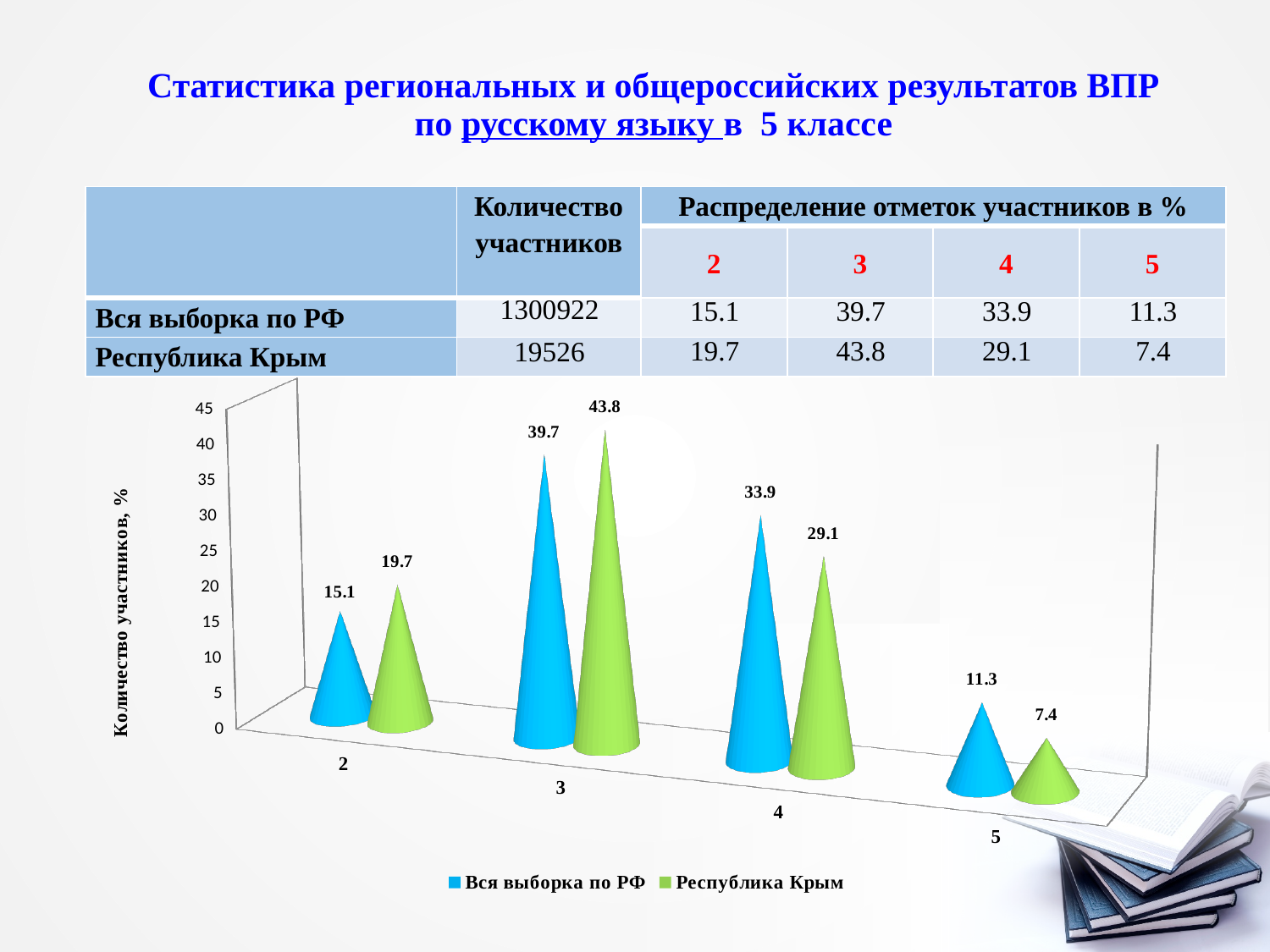
At grade 4, which series has the larger value: "Вся выборка по РФ" or "Республика Крым"? Вся выборка по РФ What is the difference between "Республика Крым" and "Вся выборка по РФ" at grade 2? 4.6 What is the value for "Республика Крым" at grade 5? 7.4 How many series does the chart legend list? 2 What is the value for "Республика Крым" at grade 3? 43.8 What kind of chart is shown on the slide? bar chart Which grade has the highest value for "Вся выборка по РФ"? 3 Which colour represents "Республика Крым" in the chart? green What is the label of the vertical axis of the chart? Количество участников, % Which grade has the lowest value for "Республика Крым"? 5 How many grade categories are shown on the x axis of the chart? 4 What is the value for "Вся выборка по РФ" at grade 4? 33.9